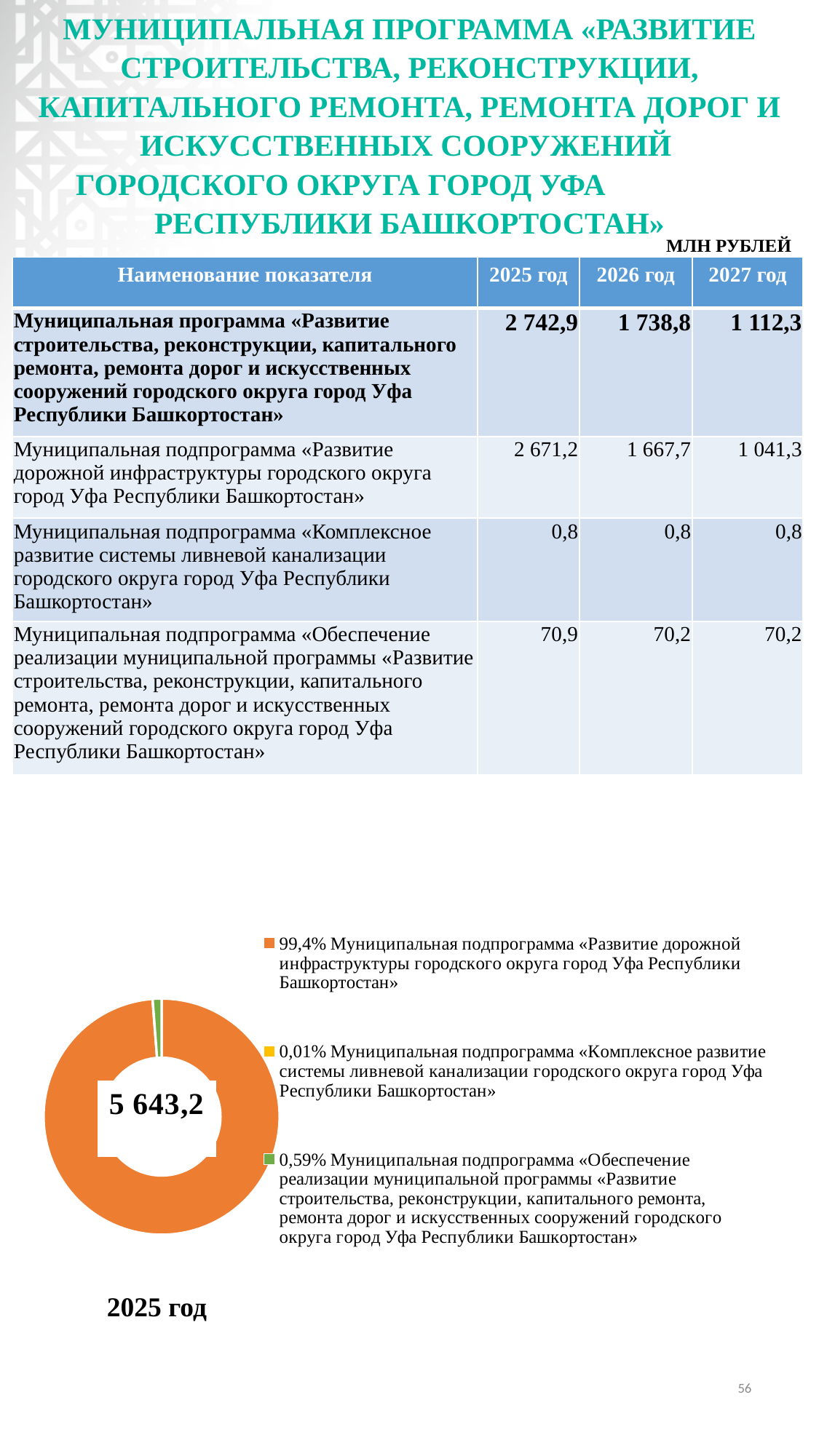
Which slice of the doughnut chart is the smallest? Муниципальная подпрограмма «Комплексное развитие системы ливневой канализации городского округа город Уфа Республики Башкортостан» What colour is the largest slice of the doughnut chart? orange How many slices does the doughnut chart have? 3 What share of the doughnut chart does the subprogramme «Обеспечение реализации муниципальной программы ...» take? 0,59% Which year is the doughnut chart labelled with? 2025 год What value is printed in the centre of the doughnut chart? 5 643,2 What share of the doughnut chart does the subprogramme «Развитие дорожной инфраструктуры городского округа город Уфа Республики Башкортостан» take? 99,4% In the doughnut chart, which share is larger: the subprogramme «Обеспечение реализации муниципальной программы ...» or the subprogramme «Комплексное развитие системы ливневой канализации ...»? «Обеспечение реализации муниципальной программы ...» (0,59%) How many entries does the legend of the doughnut chart list? 3 What share of the doughnut chart does the subprogramme «Комплексное развитие системы ливневой канализации городского округа город Уфа Республики Башкортостан» take? 0,01% Which slice of the doughnut chart is the largest? Муниципальная подпрограмма «Развитие дорожной инфраструктуры городского округа город Уфа Республики Башкортостан» What kind of chart is shown at the bottom of the slide? doughnut (pie) chart